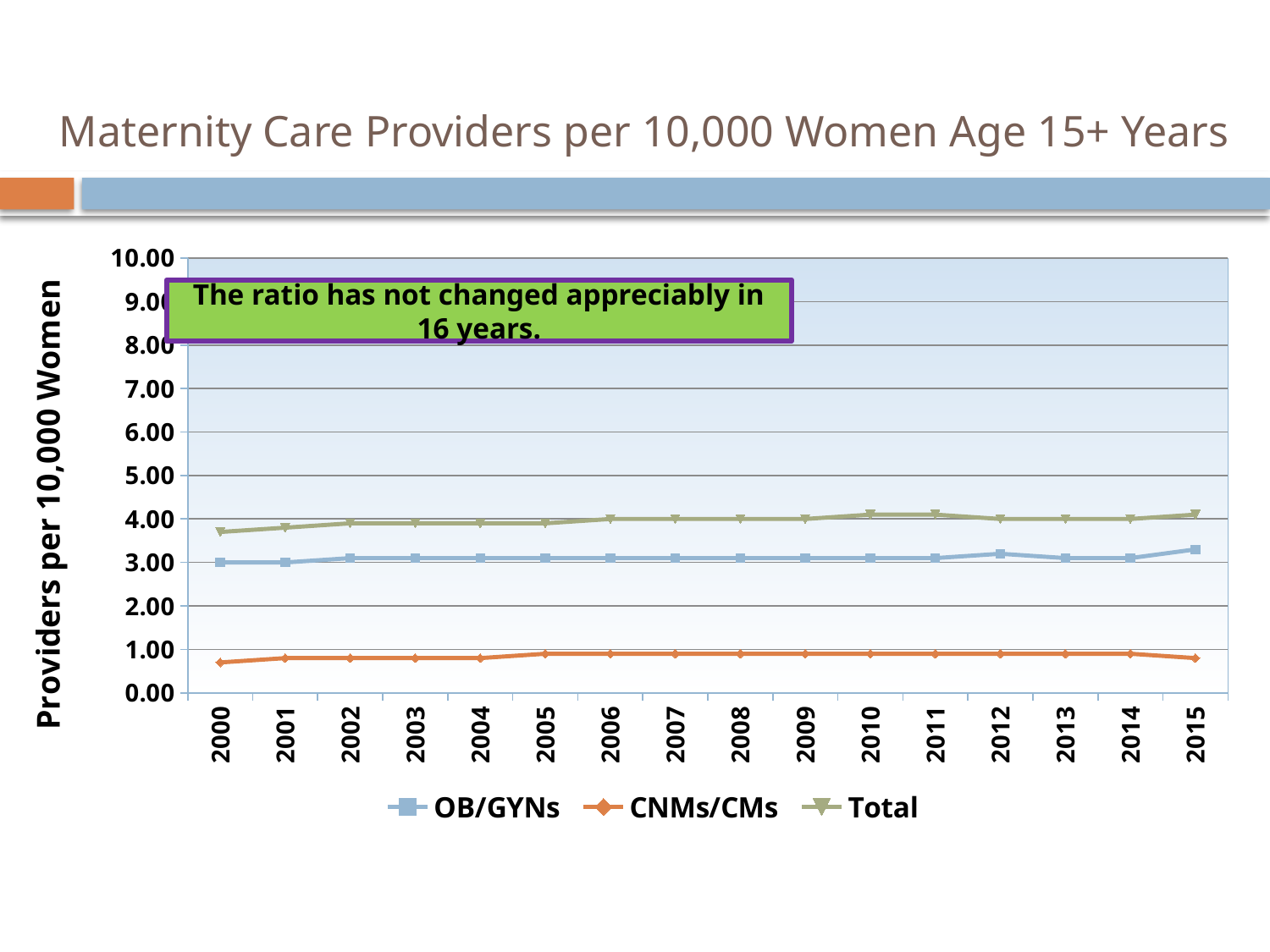
Is the value for Total in 2000 greater or less than 4.00? less How many series does the legend list? 3 Which is larger in 2008, the value for OB/GYNs or the value for CNMs/CMs? OB/GYNs What is the label on the y axis? Providers per 10,000 Women What is the value for OB/GYNs in 2000? 3.00 Does the Total line rise or fall from 2000 to 2015? rises Is the value for OB/GYNs in 2015 greater or less than 3.00? greater Which series has the highest value in 2015? Total What kind of chart is shown on the slide? line chart How many years are plotted along the x axis? 16 Which series has the lowest values across all years? CNMs/CMs Is the value for CNMs/CMs in 2000 greater or less than 1.00? less